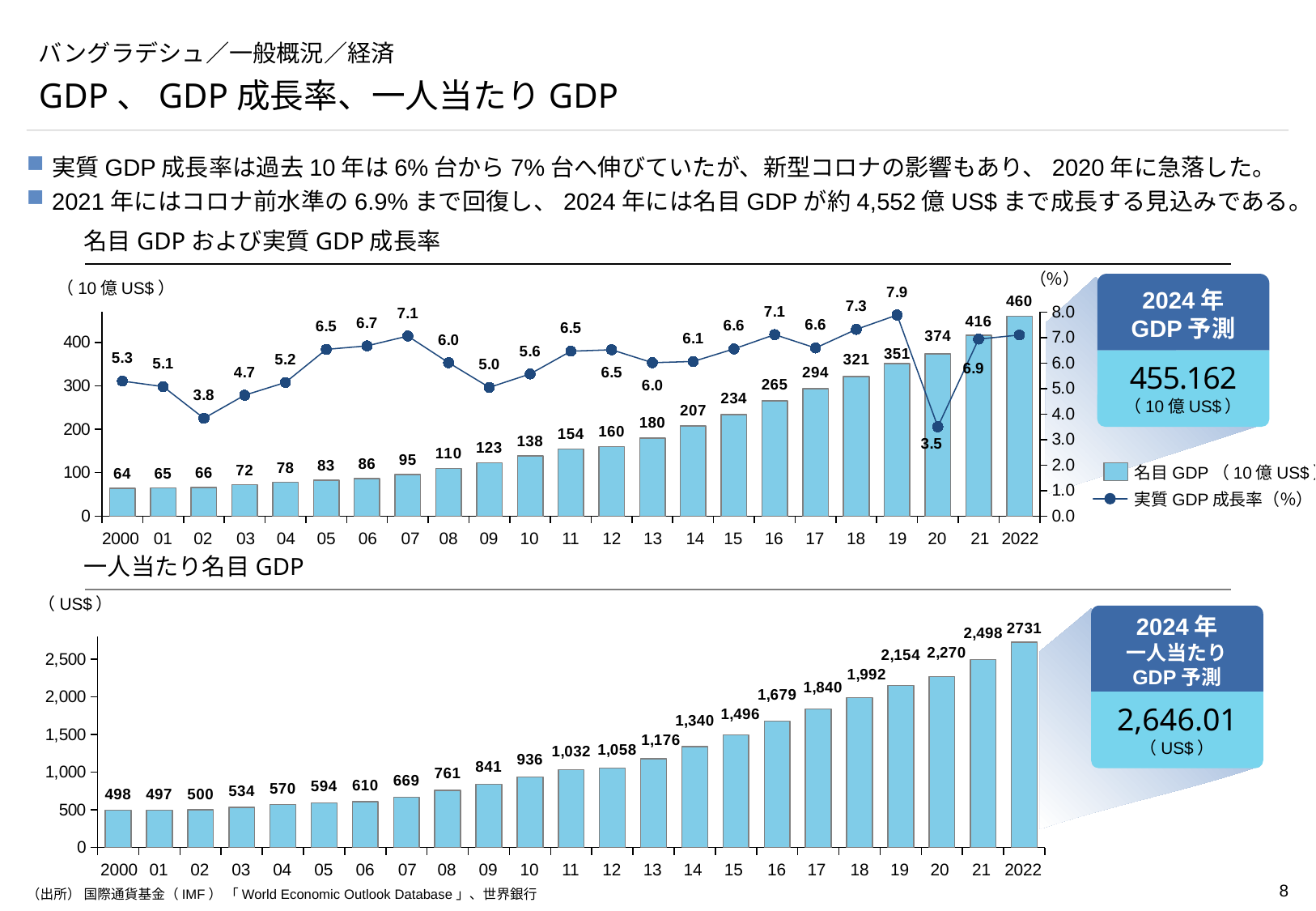
In the top chart (名目GDPおよび実質GDP成長率), in which year is the real GDP growth rate lowest? 20 In the bottom chart (一人当たり名目GDP), what is the difference between the values for 21 and 20? 228 In the bottom chart (一人当たり名目GDP), what is the value for 2022? 2731 In the top chart (名目GDPおよび実質GDP成長率), what is the real GDP growth rate for 2020? 3.5 In the bottom chart (一人当たり名目GDP), how many years are plotted? 23 In the top chart (名目GDPおよび実質GDP成長率), is the real GDP growth rate for 07 higher or lower than for 08? higher In the top chart (名目GDPおよび実質GDP成長率), in which year is the real GDP growth rate highest? 19 In the top chart (名目GDPおよび実質GDP成長率), what is the nominal GDP value for 2022? 460 What kind of chart is the bottom chart (一人当たり名目GDP)? bar chart In the top chart (名目GDPおよび実質GDP成長率), what is the difference between the nominal GDP values for 2022 and 21? 44 In the bottom chart (一人当たり名目GDP), which year has the lowest value? 01 In the top chart (名目GDPおよび実質GDP成長率), how many series does the legend list? 2